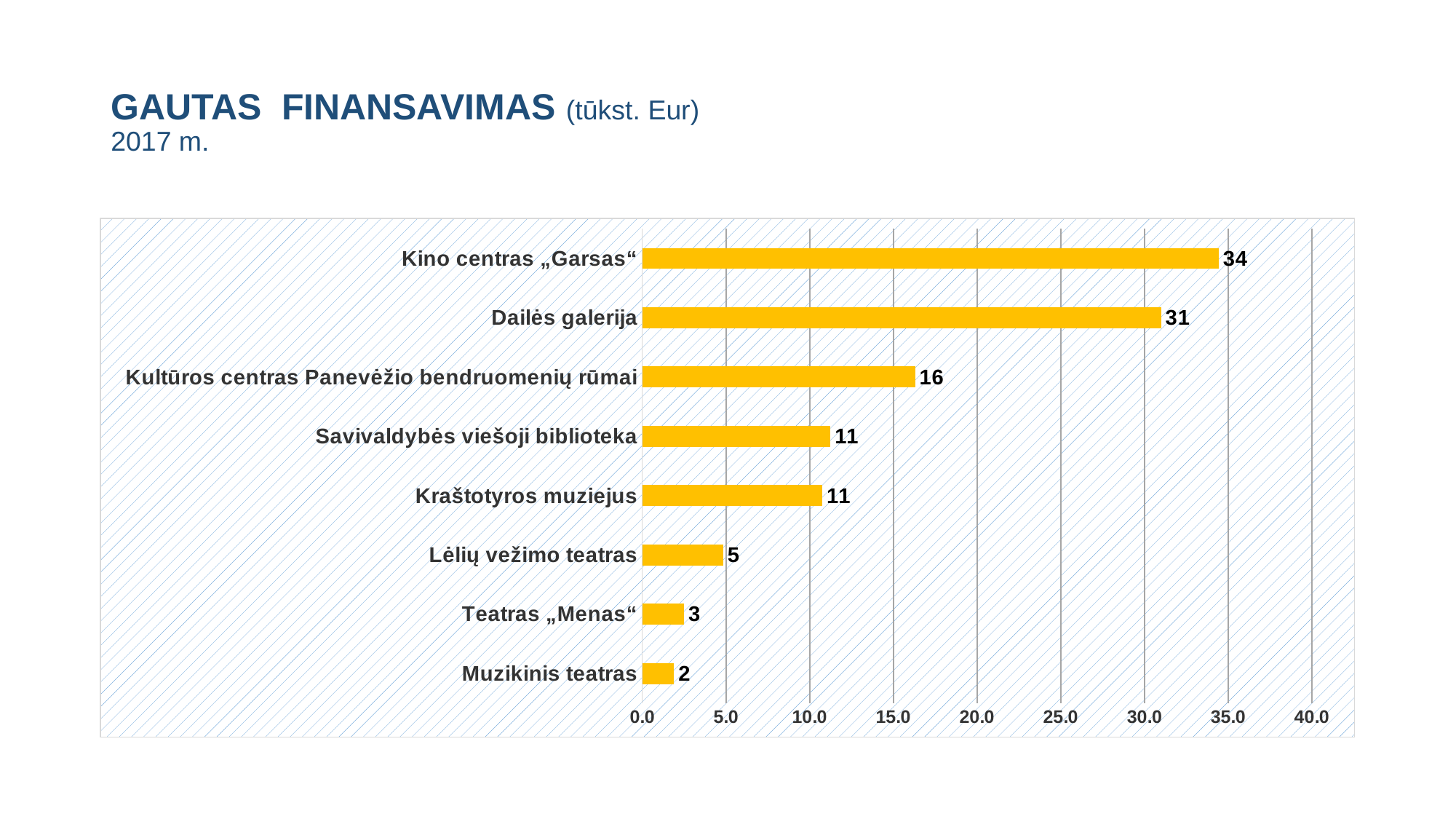
Which category has the lowest value? Muzikinis teatras What is the difference between the values for Kino centras „Garsas“ and Dailės galerija? 3 What value is shown for Dailės galerija? 31 What value is shown for Kino centras „Garsas“? 34 Which has a larger value, Dailės galerija or Savivaldybės viešoji biblioteka? Dailės galerija What value is shown for Kultūros centras Panevėžio bendruomenių rūmai? 16 Which category has the highest value? Kino centras „Garsas“ What value is shown for Lėlių vežimo teatras? 5 How many categories are shown in the chart? 8 What is the title of the chart on the slide? GAUTAS FINANSAVIMAS (tūkst. Eur) 2017 m. What kind of chart is shown on the slide? Bar chart What is the difference between the values for Kultūros centras Panevėžio bendruomenių rūmai and Teatras „Menas“? 13